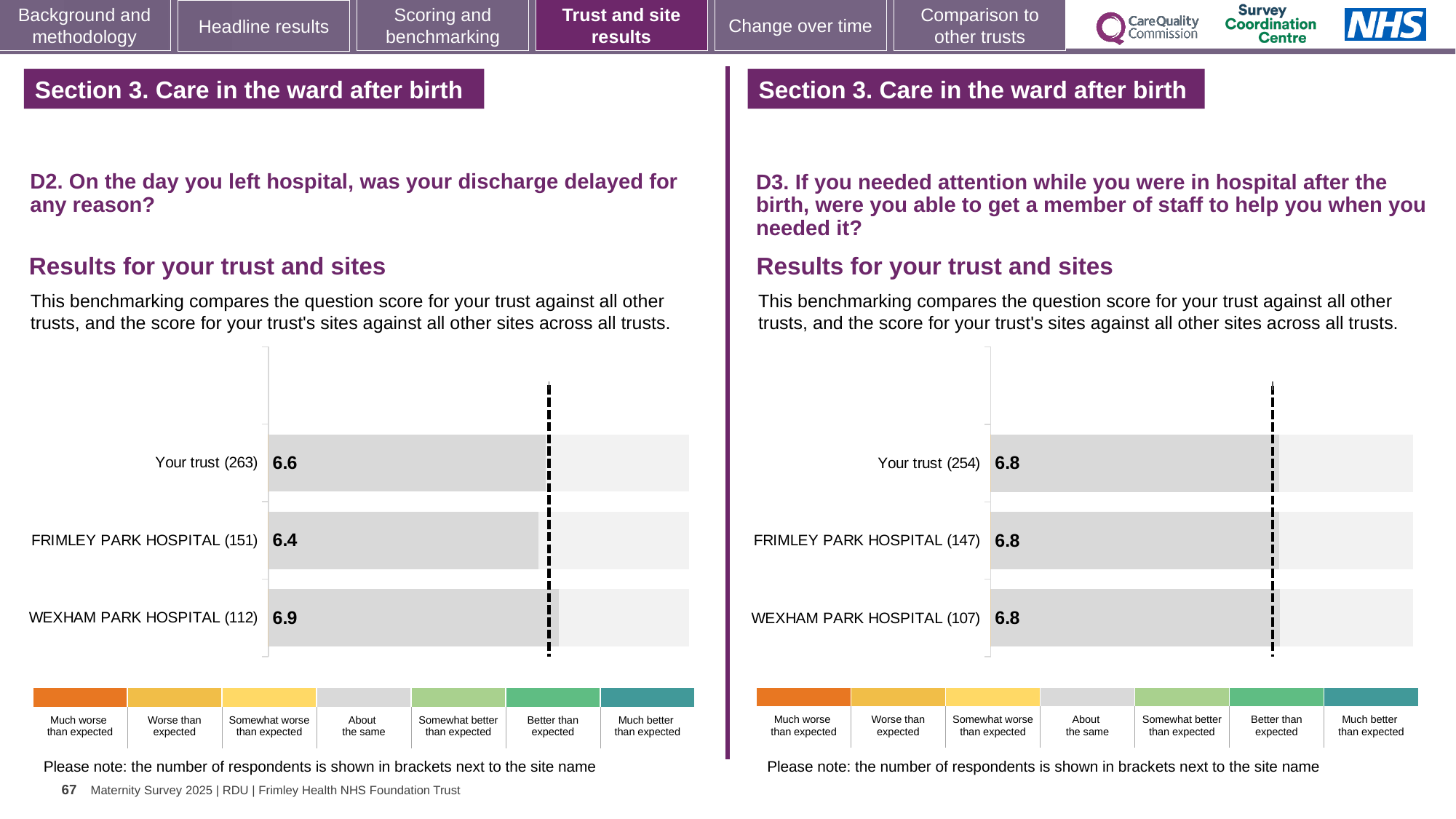
In the D2 chart on the left, how many respondents are shown in brackets for Your trust? 263 In the D3 chart on the right, how many respondents are shown in brackets for FRIMLEY PARK HOSPITAL? 147 In the D3 chart on the right, what is the score for WEXHAM PARK HOSPITAL? 6.8 In the D2 chart on the left, how many bars are plotted? 3 In the D3 chart on the right, what is the score for Your trust? 6.8 What type of chart is used in the D2 chart on the left? Bar chart In the D2 chart on the left, which site or trust has the highest score? WEXHAM PARK HOSPITAL In the D2 chart on the left, what is the score for FRIMLEY PARK HOSPITAL? 6.4 In the D2 chart on the left, what is the score for Your trust? 6.6 In the D2 chart on the left, what is the score for WEXHAM PARK HOSPITAL? 6.9 In the D2 chart on the left, which site or trust has the lowest score? FRIMLEY PARK HOSPITAL In the D2 chart on the left, what is the difference between the scores for WEXHAM PARK HOSPITAL and FRIMLEY PARK HOSPITAL? 0.5